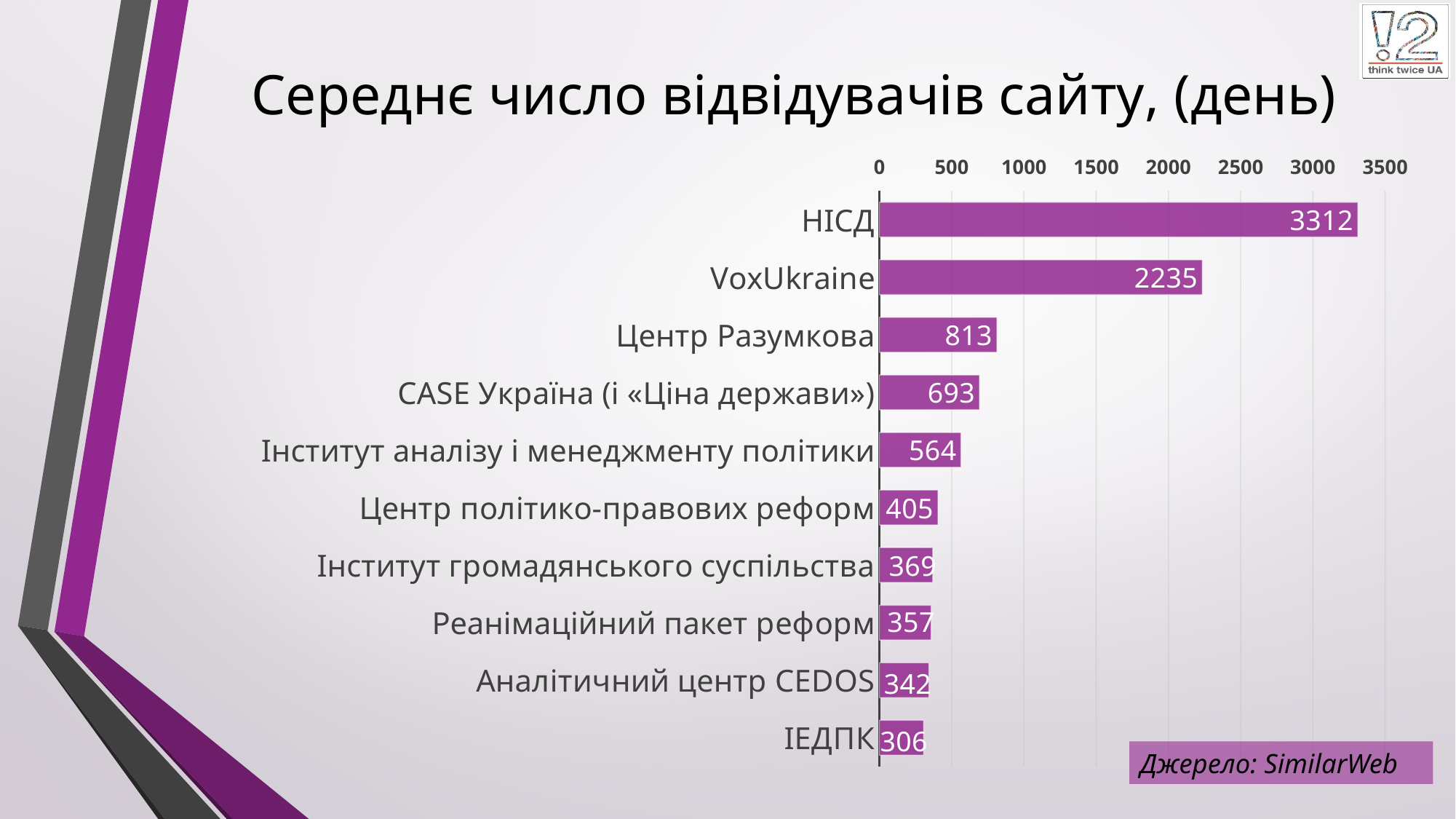
What is the value shown for VoxUkraine? 2235 What is the difference between the values for Центр Разумкова and CASE Україна (і «Ціна держави»)? 120 Which organisation has the lowest average daily number of site visitors? ІЕДПК What is the title of the chart? Середнє число відвідувачів сайту, (день) What kind of chart is shown on the slide? Bar chart Which has a larger value: Інститут аналізу і менеджменту політики or Центр політико-правових реформ? Інститут аналізу і менеджменту політики Which organisation has the highest average daily number of site visitors? НІСД How many organisations are shown in the chart? 10 What is the difference between the values for НІСД and VoxUkraine? 1077 What is the value shown for Центр Разумкова? 813 What is the value shown for Реанімаційний пакет реформ? 357 What is the average daily number of site visitors for НІСД? 3312